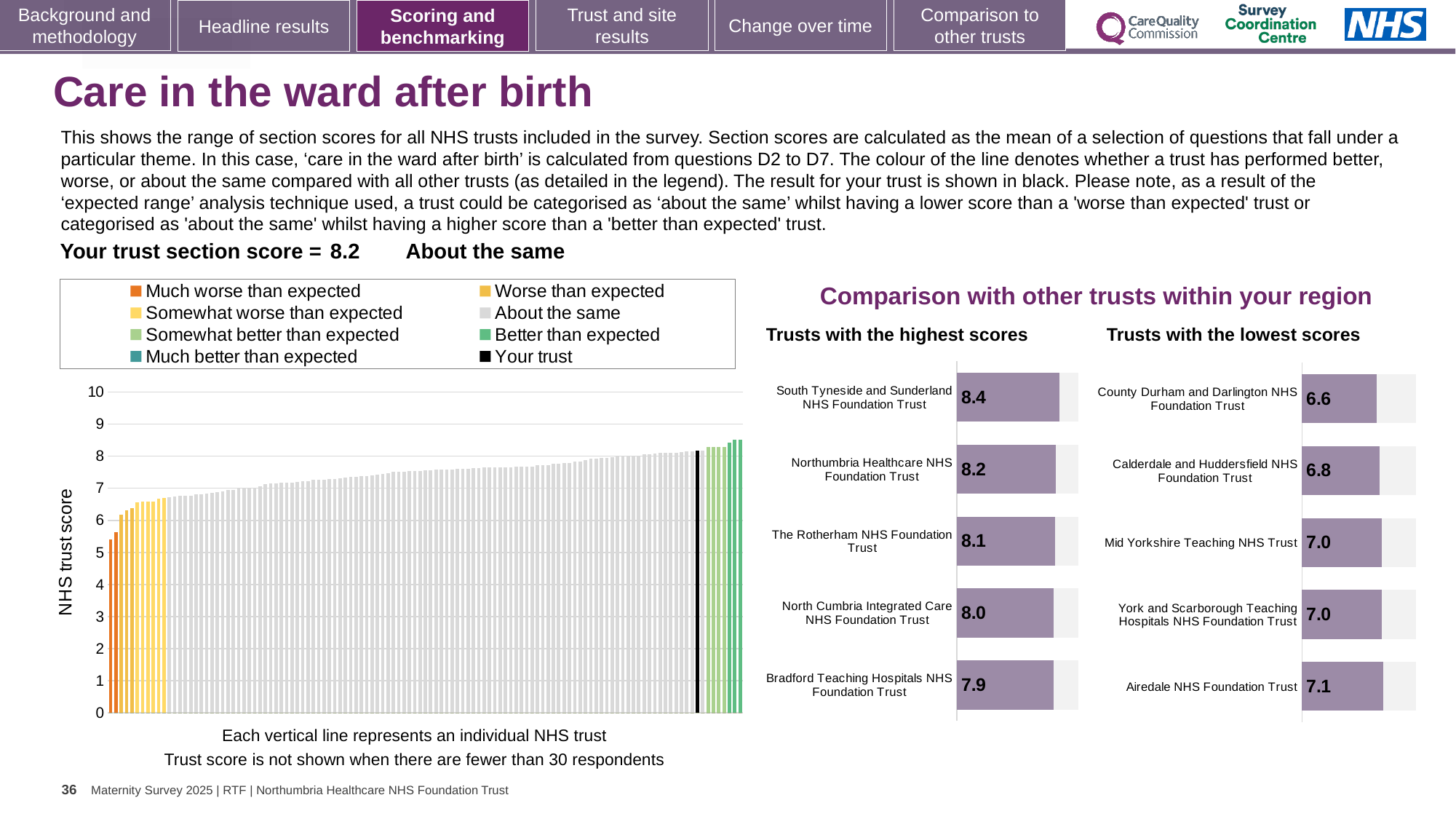
How many trusts are shown in the 'Trusts with the highest scores' chart? 5 In the 'Trusts with the highest scores' chart, what is the difference between the scores of South Tyneside and Sunderland NHS Foundation Trust and Bradford Teaching Hospitals NHS Foundation Trust? 0.5 In the 'Trusts with the lowest scores' chart, which has the larger score: Calderdale and Huddersfield NHS Foundation Trust or Airedale NHS Foundation Trust? Airedale NHS Foundation Trust In the 'Trusts with the lowest scores' chart, which trust has the lowest score? County Durham and Darlington NHS Foundation Trust How many entries does the legend above the 'NHS trust score' chart list? 8 What kind of chart is the 'NHS trust score' chart on the left of the slide? Bar chart In the 'Trusts with the lowest scores' chart, what is the score for Airedale NHS Foundation Trust? 7.1 In the 'Trusts with the highest scores' chart, what is the score for South Tyneside and Sunderland NHS Foundation Trust? 8.4 In the 'NHS trust score' chart on the left, do the bar values rise or fall from left to right? Rise In the 'Trusts with the lowest scores' chart, what is the score for County Durham and Darlington NHS Foundation Trust? 6.6 In the 'Trusts with the highest scores' chart, which trust has the highest score? South Tyneside and Sunderland NHS Foundation Trust In the 'Trusts with the highest scores' chart, what is the score for Bradford Teaching Hospitals NHS Foundation Trust? 7.9